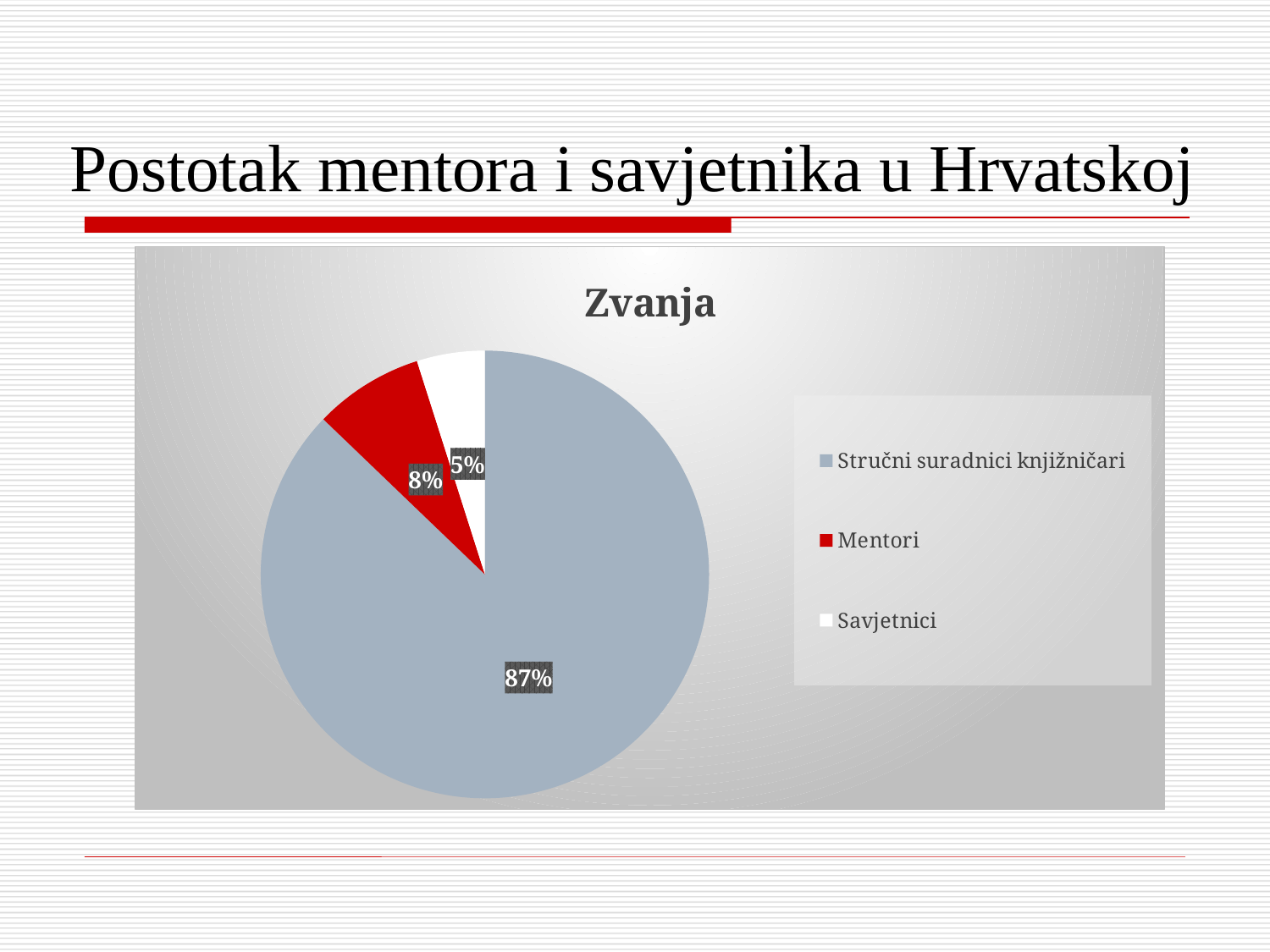
What percentage of the pie is Savjetnici? 5% How many entries does the legend list? 3 Which is larger, the share for Mentori or the share for Savjetnici? Mentori What percentage of the pie is Stručni suradnici knjižničari? 87% What percentage of the pie is Mentori? 8% What colour is the Mentori slice? red What kind of chart is shown on the slide? pie chart What is the difference in percentage points between Stručni suradnici knjižničari and Mentori? 79 What is the title of the chart? Zvanja Which category has the smallest share of the pie? Savjetnici How many slices does the pie chart have? 3 Which category has the largest share of the pie? Stručni suradnici knjižničari